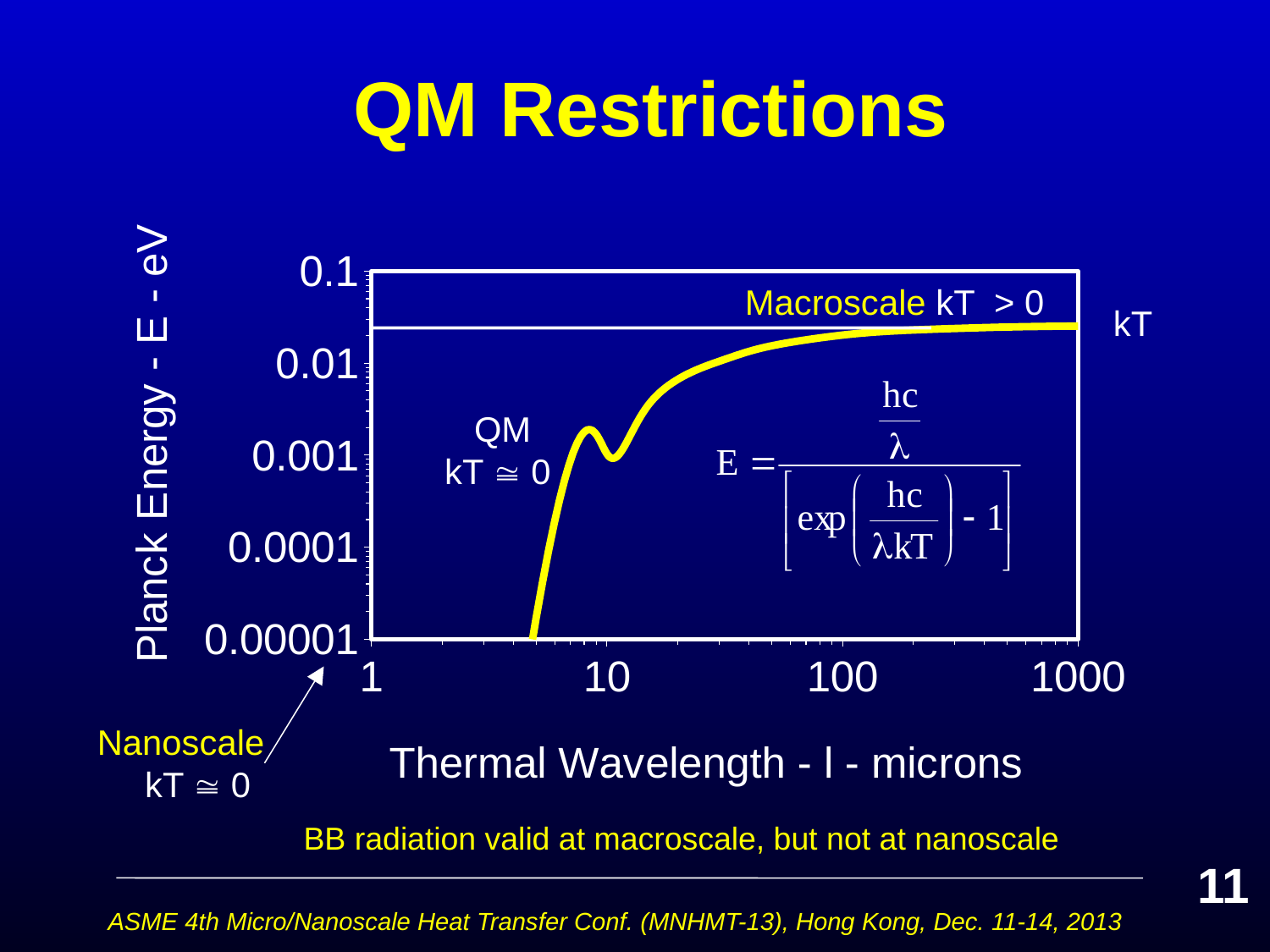
What is the title of the slide containing the chart? QM Restrictions Is the Planck energy at a thermal wavelength of 1000 microns greater or less than 0.01 eV? greater How many curves are plotted on the chart? 1 Does the Planck energy curve generally rise or fall as thermal wavelength increases from 10 to 1000 microns? rise Is the Planck energy at a thermal wavelength of 100 microns greater or less than 0.001 eV? greater What is the label of the y axis of the chart? Planck Energy - E - eV Is the Planck energy higher at 1000 microns or at 10 microns? 1000 microns What is the highest value labeled on the y axis of the chart? 0.1 What is the lowest value labeled on the y axis of the chart? 0.00001 Is the Planck energy at a thermal wavelength of 10 microns greater or less than 0.01 eV? less What kind of chart is shown on the slide? line chart How many labeled tick values are shown on the x axis of the chart? 4